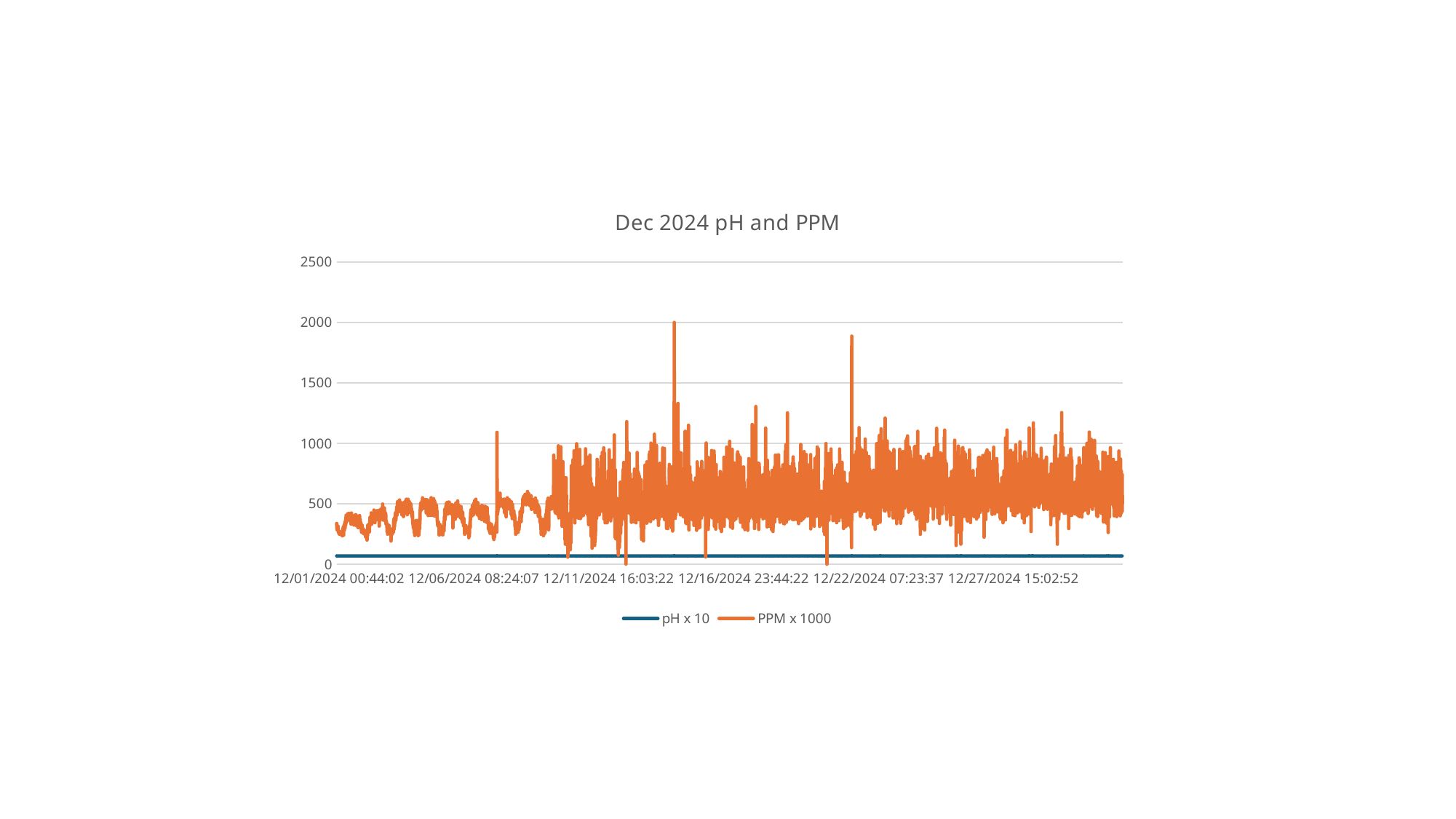
What is the highest value shown on the vertical axis? 2500 Does the PPM x 1000 series generally rise or fall from the start of December to the end? rise Is the value of the PPM x 1000 series at the start of the chart (12/01/2024) greater or less than 1000? less How many series does the legend list? 2 Is the highest peak of the PPM x 1000 series greater or less than 1500? greater What kind of chart is shown on the slide? line chart Which series is drawn in orange? PPM x 1000 Is the highest peak of the PPM x 1000 series greater or less than 2500? less Which series has the higher values across the chart, pH x 10 or PPM x 1000? PPM x 1000 What is the title of the chart? Dec 2024 pH and PPM